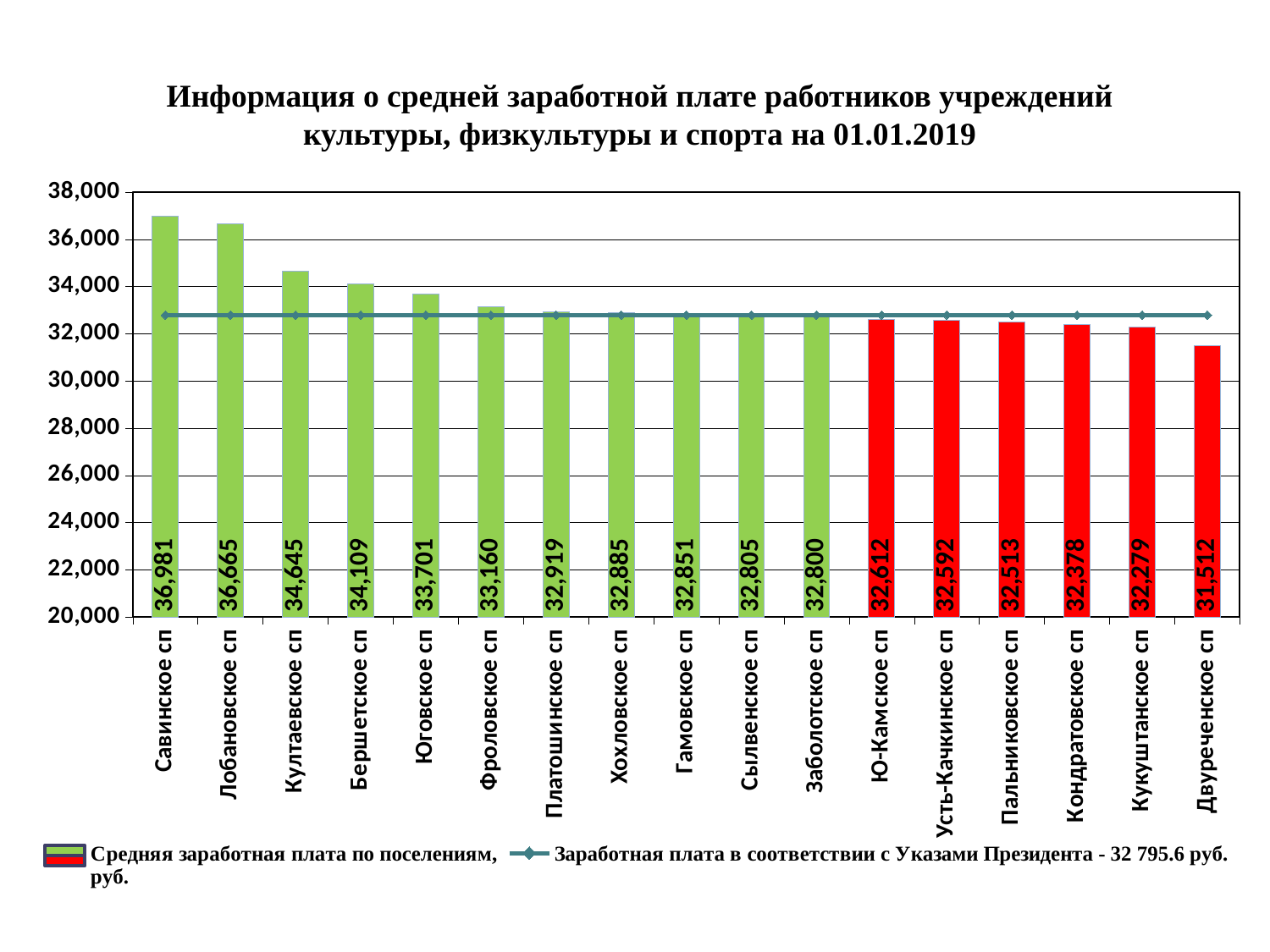
Which settlement has the lowest average salary on the chart? Двуреченское сп What is the value shown for Двуреченское сп? 31,512 What is the difference between the values for Савинское сп and Двуреченское сп? 5,469 Which settlement has the highest average salary on the chart? Савинское сп How many series does the legend list? 2 What is the average salary value shown for Савинское сп? 36,981 Is the value for Кукуштанское сп greater or less than 34,000? less What salary level does the horizontal line represent according to the legend? 32 795.6 руб. What is the value shown for Фроловское сп? 33,160 What is the difference between the values for Култаевское сп and Бершетское сп? 536 How many settlements (bars) are shown on the chart? 17 Which has a larger value, Лобановское сп or Юговское сп? Лобановское сп